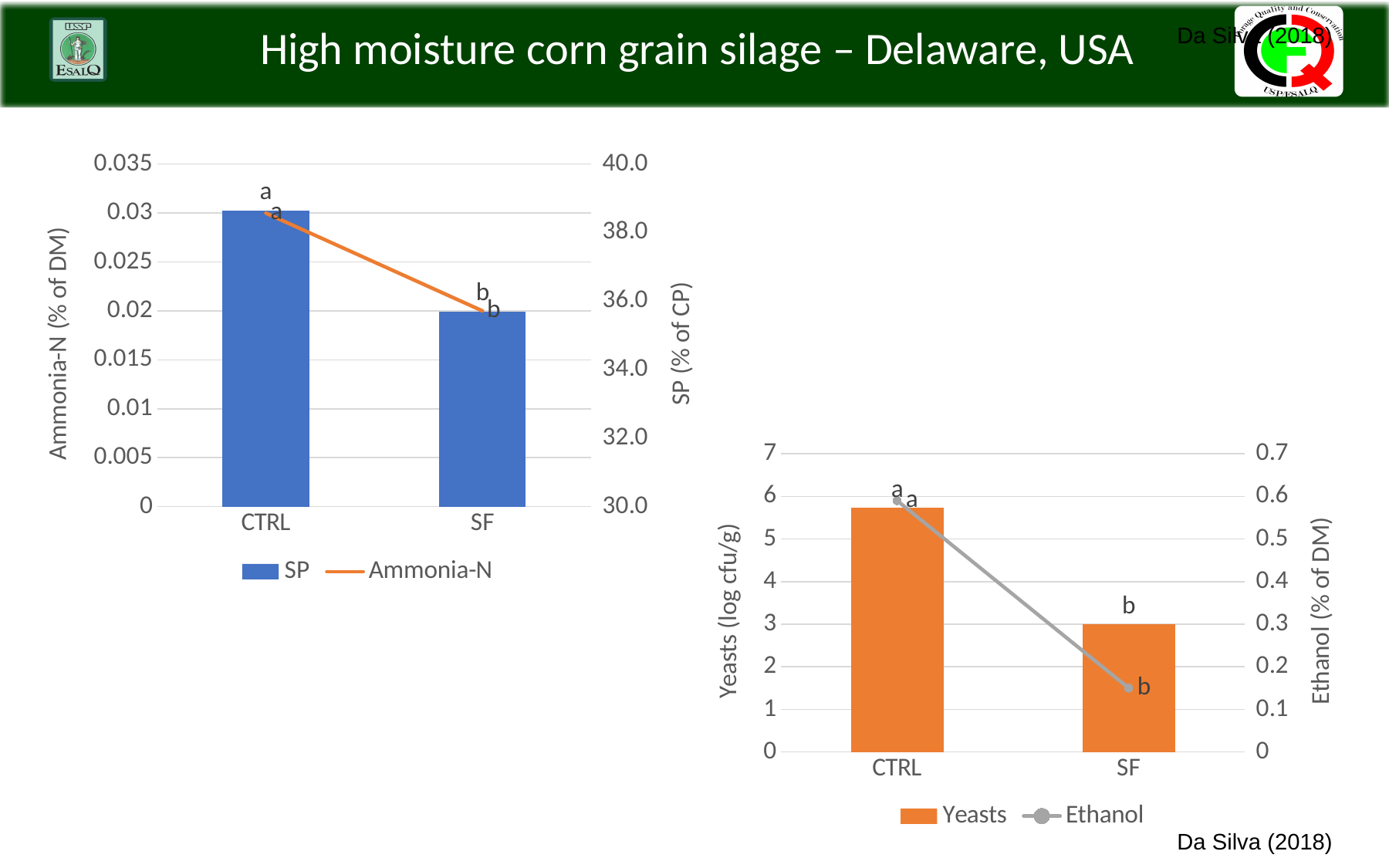
On the left chart, which treatment has the taller SP bar, CTRL or SF? CTRL What are the two series listed in the legend of the left chart? SP and Ammonia-N On the right chart, is the Ethanol value for SF greater or less than 0.2? less On the right chart, does the Ethanol line rise or fall from CTRL to SF? fall On the right chart, is the Yeasts value for CTRL greater or less than 5? greater On the left chart, does the Ammonia-N line rise or fall from CTRL to SF? fall How many categories are shown on the x axis of the left chart? 2 On the right chart, which treatment has the higher Yeasts value? CTRL On the right chart, what is the Yeasts value for SF? 3 On the right chart, is the Ethanol value for CTRL greater or less than 0.5? greater What is the title of the right-hand vertical axis on the right chart? Ethanol (% of DM) How many series does the legend of the right chart list? 2